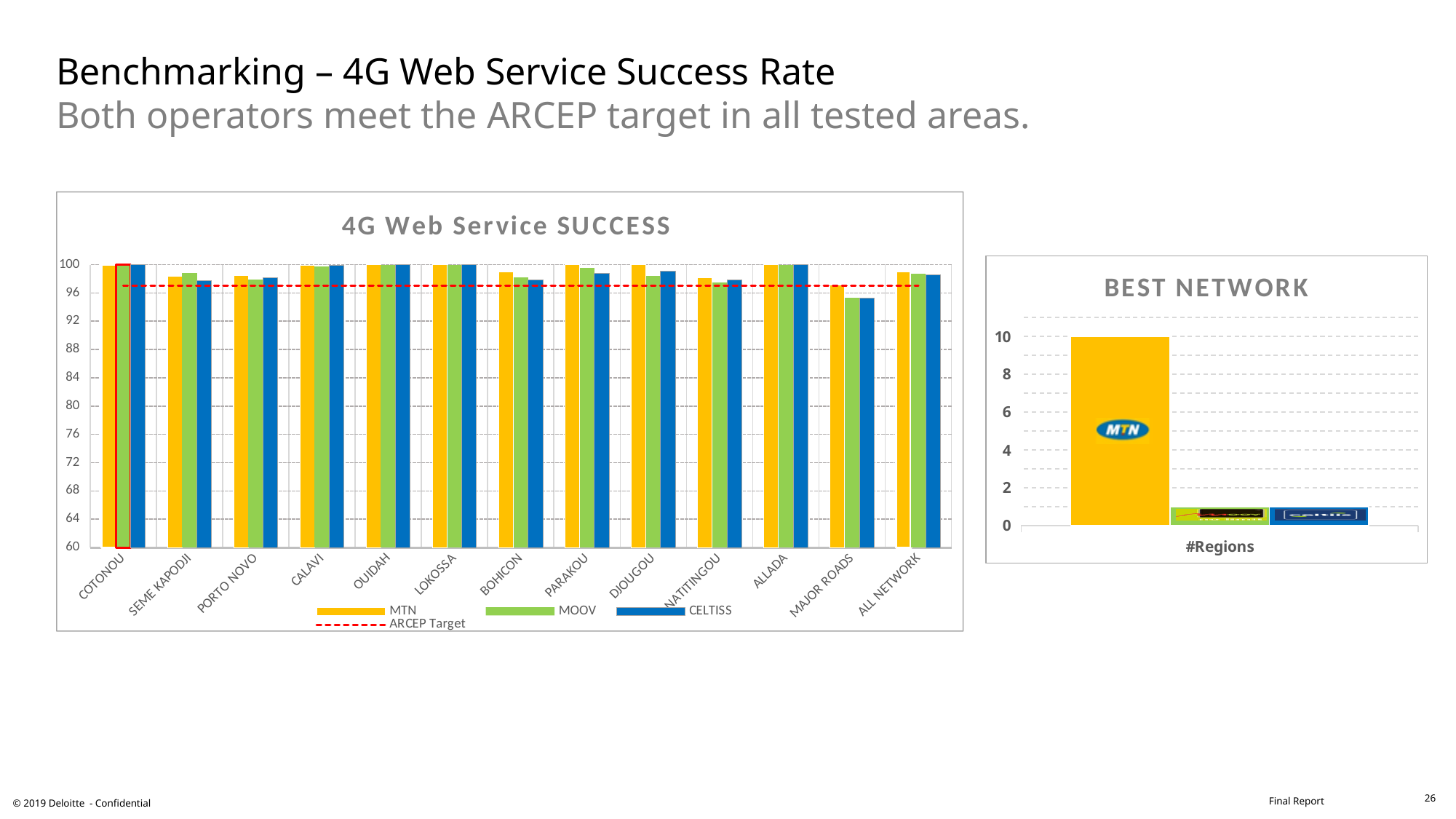
In the 'BEST NETWORK' chart, which operator has the highest bar? MTN How many categories are shown on the x axis of the '4G Web Service SUCCESS' chart? 13 In the '4G Web Service SUCCESS' chart, is the MOOV value for MAJOR ROADS greater or less than 92? greater In the '4G Web Service SUCCESS' chart, is the MTN value for COTONOU greater or less than 96? greater In the 'BEST NETWORK' chart, is the value for MOOV greater or less than 2? less In the '4G Web Service SUCCESS' chart, what does the red dashed line represent? ARCEP Target What kind of chart is the '4G Web Service SUCCESS' chart? bar chart In the '4G Web Service SUCCESS' chart, which category has the lowest values? MAJOR ROADS How many entries does the legend of the '4G Web Service SUCCESS' chart list? 4 In the 'BEST NETWORK' chart, which is larger, the value for MTN or the value for CELTISS? MTN In the 'BEST NETWORK' chart, what is the value for MTN? 10 In the '4G Web Service SUCCESS' chart, which operator is represented by the yellow bars? MTN